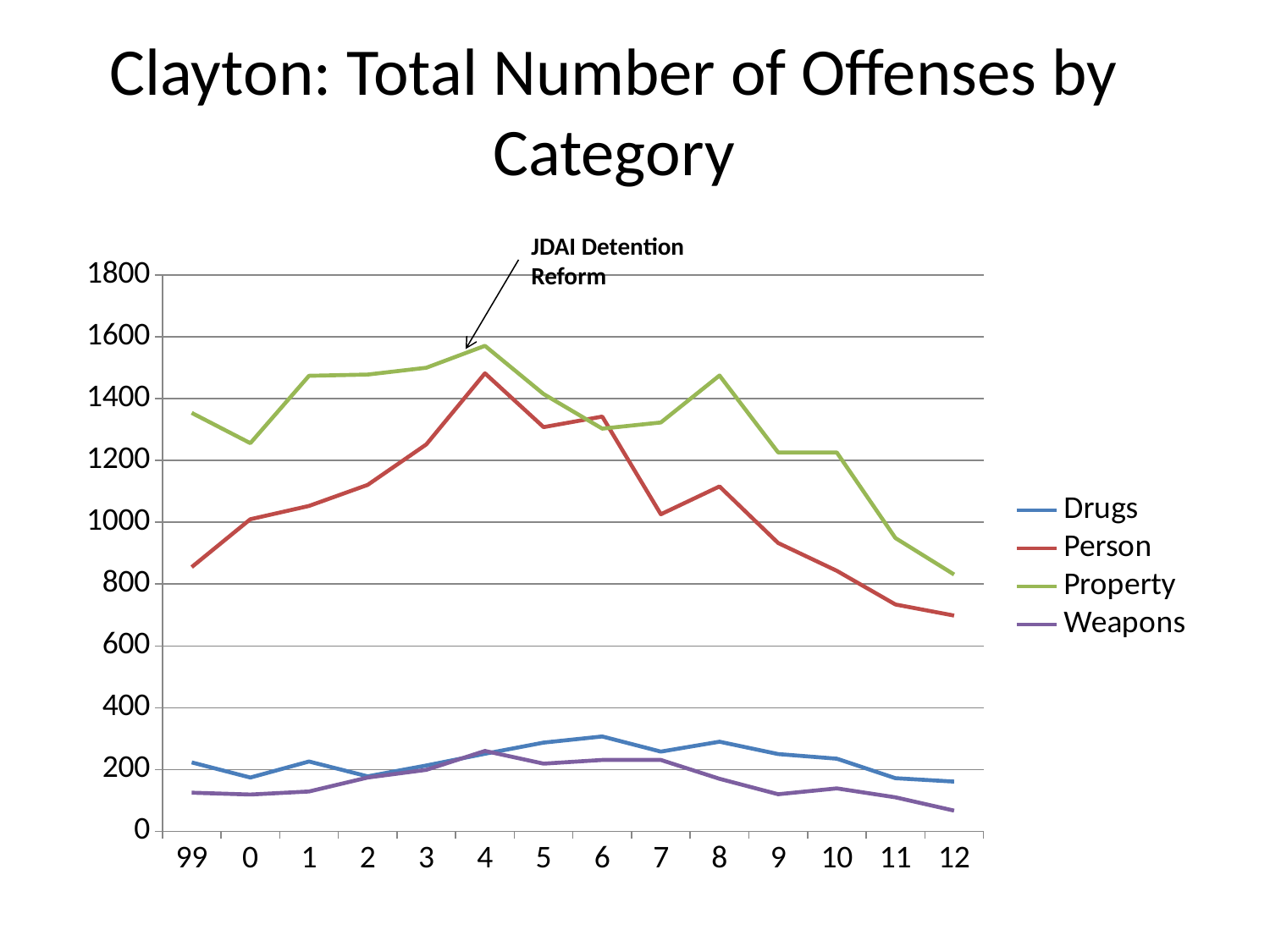
Is the value for Property at 4 greater or less than 1400? greater Is the value for Person at 12 greater or less than 800? less What kind of chart is shown on the slide? line chart How many points are there along the x axis? 14 At which x-axis point does the Property series reach its highest value? 4 At 99, which series has the larger value, Property or Person? Property Does the Person series rise or fall from 8 to 12? fall Is the value for Weapons at 12 greater or less than 100? less Which x-axis point does the 'JDAI Detention Reform' annotation arrow point to? 4 At which x-axis point is the Weapons series at its lowest? 12 At which x-axis point does the Person series reach its highest value? 4 How many series does the legend list? 4